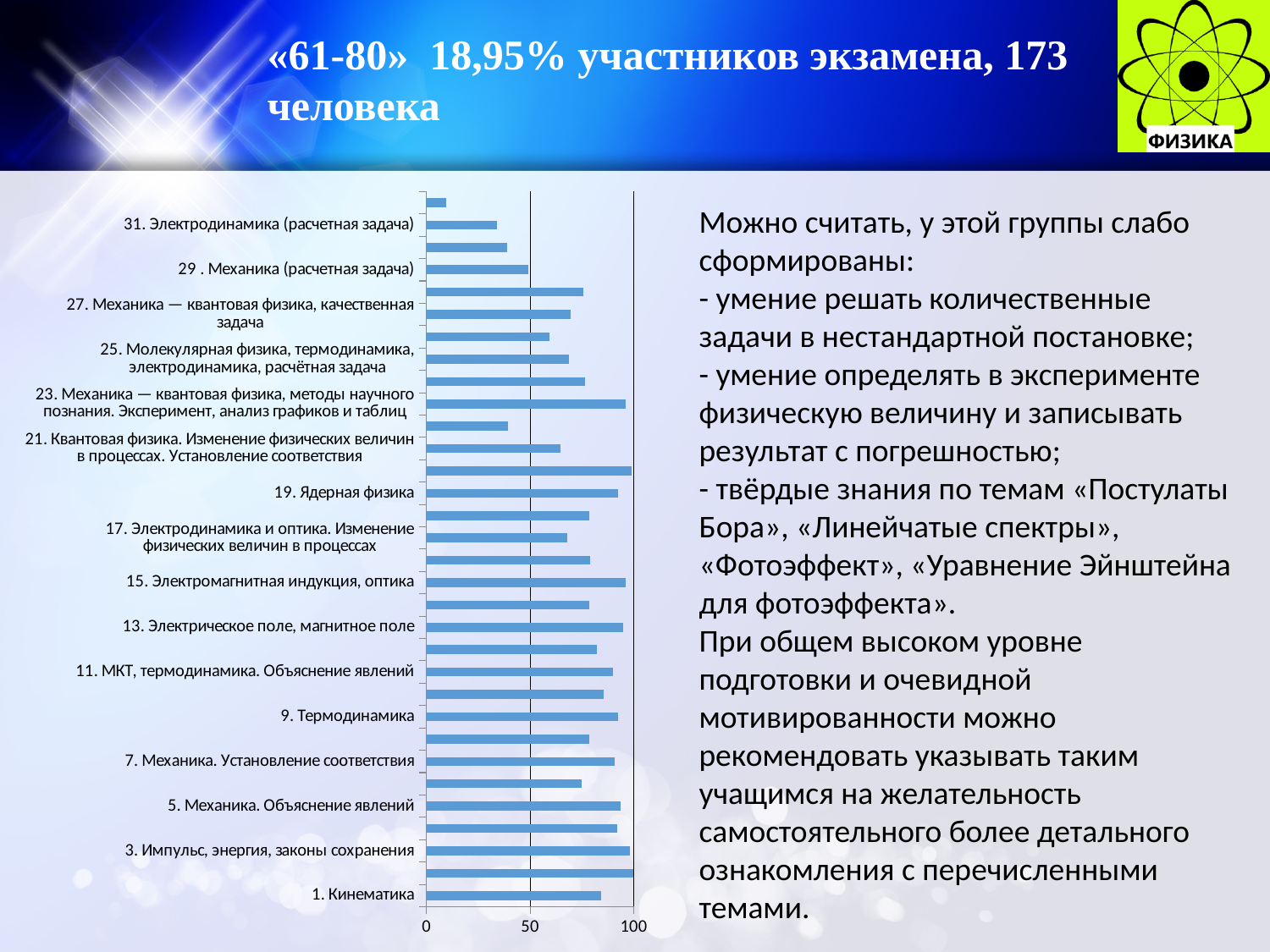
What is the highest tick value shown on the horizontal axis of the chart? 100 How many bars does the chart contain? 32 Is the value for "25. Молекулярная физика, термодинамика, электродинамика, расчётная задача" greater or less than 50? greater Is the value for "21. Квантовая физика. Изменение физических величин в процессах. Установление соответствия" greater or less than 50? greater Which has the larger value: "13. Электрическое поле, магнитное поле" or "21. Квантовая физика. Изменение физических величин в процессах. Установление соответствия"? 13. Электрическое поле, магнитное поле Which has the larger value: "1. Кинематика" or "31. Электродинамика (расчетная задача)"? 1. Кинематика What kind of chart is shown on the slide? bar chart Is the value for "3. Импульс, энергия, законы сохранения" greater or less than 50? greater Which has the larger value: "3. Импульс, энергия, законы сохранения" or "29 . Механика (расчетная задача)"? 3. Импульс, энергия, законы сохранения